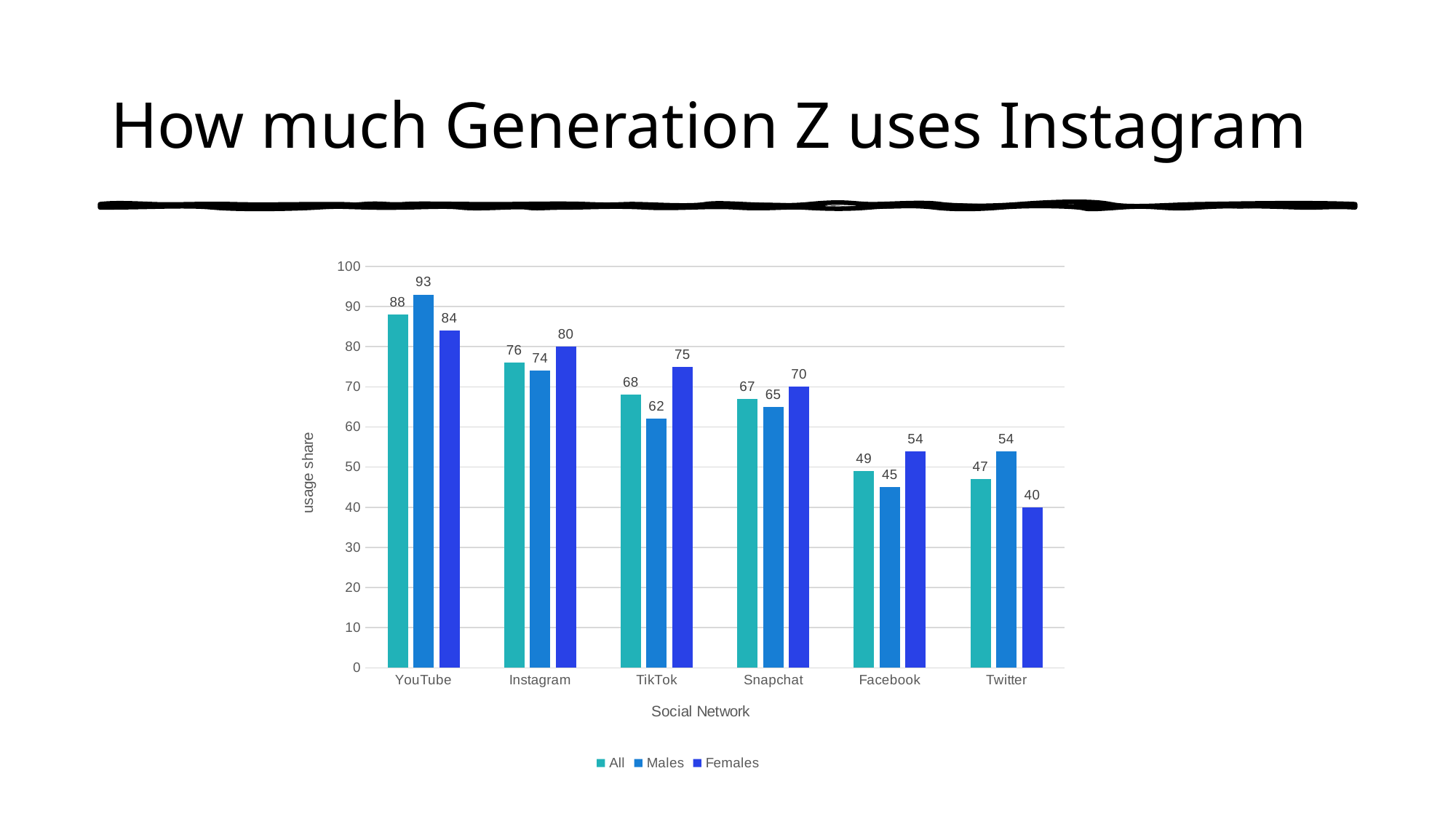
Is the usage share for Females on Facebook greater or less than 50? greater What kind of chart is shown on the slide? bar chart What is the usage share for Females on Twitter? 40 What is the difference between the Females and Males usage share on TikTok? 13 What is the usage share for All on TikTok? 68 How many series does the legend list? 3 Which is larger on Instagram: the Males usage share or the Females usage share? Females Which social network has the highest usage share for the All series? YouTube Which social network has the lowest usage share for Males? Facebook What is the label of the y axis? usage share What is the usage share for Males on YouTube? 93 How many social networks are shown on the x axis? 6